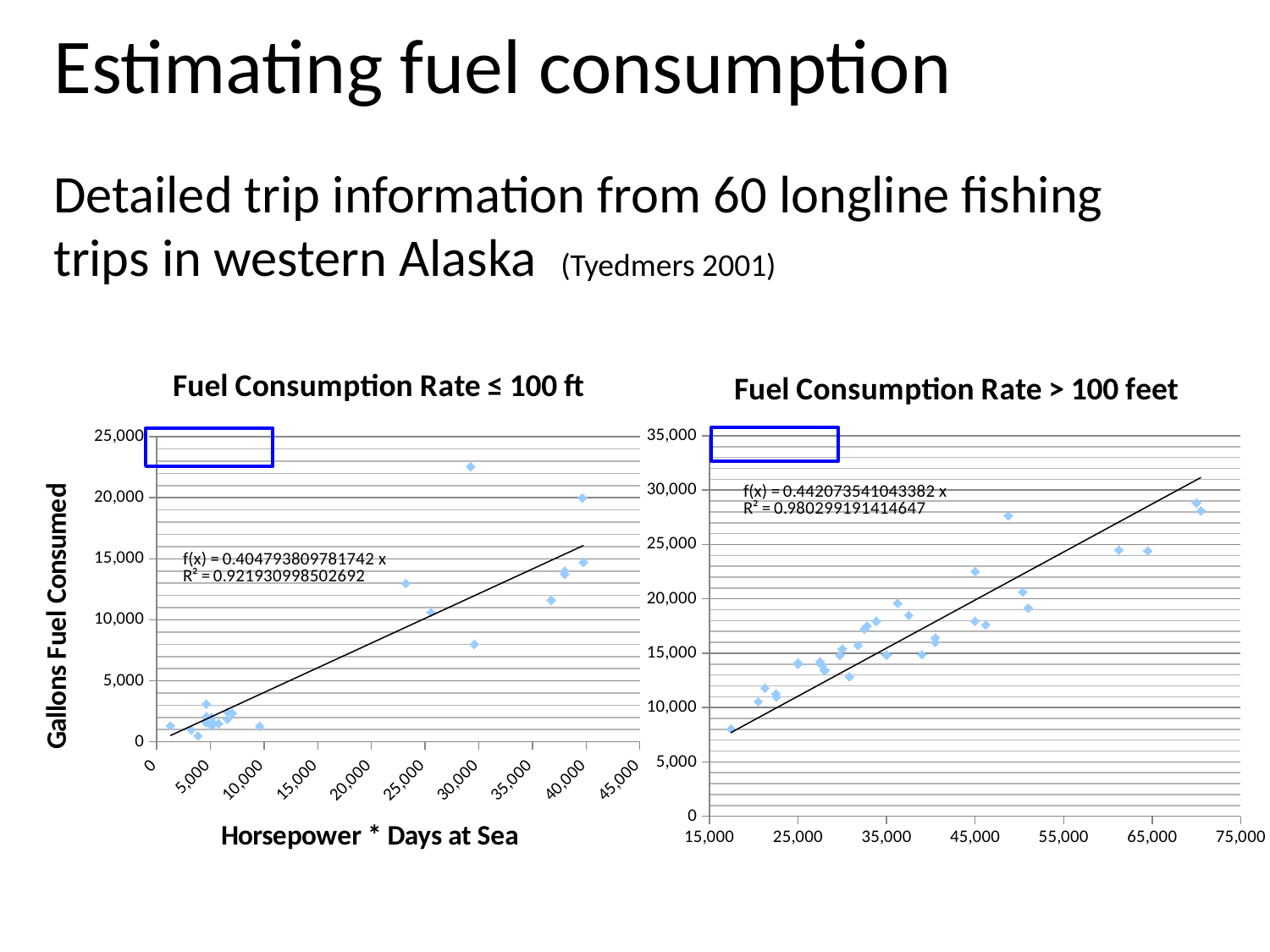
What is the trendline equation printed on the right chart 'Fuel Consumption Rate > 100 feet'? f(x) = 0.442073541043382 x In the left chart 'Fuel Consumption Rate ≤ 100 ft', do the plotted values generally rise or fall as Horsepower * Days at Sea increases? rise What kind of chart is the right chart titled 'Fuel Consumption Rate > 100 feet'? scatter chart What is the trendline equation printed on the left chart 'Fuel Consumption Rate ≤ 100 ft'? f(x) = 0.404793809781742 x What kind of chart is the left chart titled 'Fuel Consumption Rate ≤ 100 ft'? scatter chart What is the R² value printed on the right chart 'Fuel Consumption Rate > 100 feet'? 0.980299191414647 What is the R² value printed on the left chart 'Fuel Consumption Rate ≤ 100 ft'? 0.921930998502692 In the right chart 'Fuel Consumption Rate > 100 feet', do the plotted values generally rise or fall along the x axis? rise Which chart has the higher R² value, 'Fuel Consumption Rate ≤ 100 ft' or 'Fuel Consumption Rate > 100 feet'? Fuel Consumption Rate > 100 feet What is the x-axis title of the left chart 'Fuel Consumption Rate ≤ 100 ft'? Horsepower * Days at Sea In the right chart 'Fuel Consumption Rate > 100 feet', is the lowest plotted point greater or less than 10,000? less In the left chart 'Fuel Consumption Rate ≤ 100 ft', is the highest plotted point greater or less than 20,000 gallons? greater